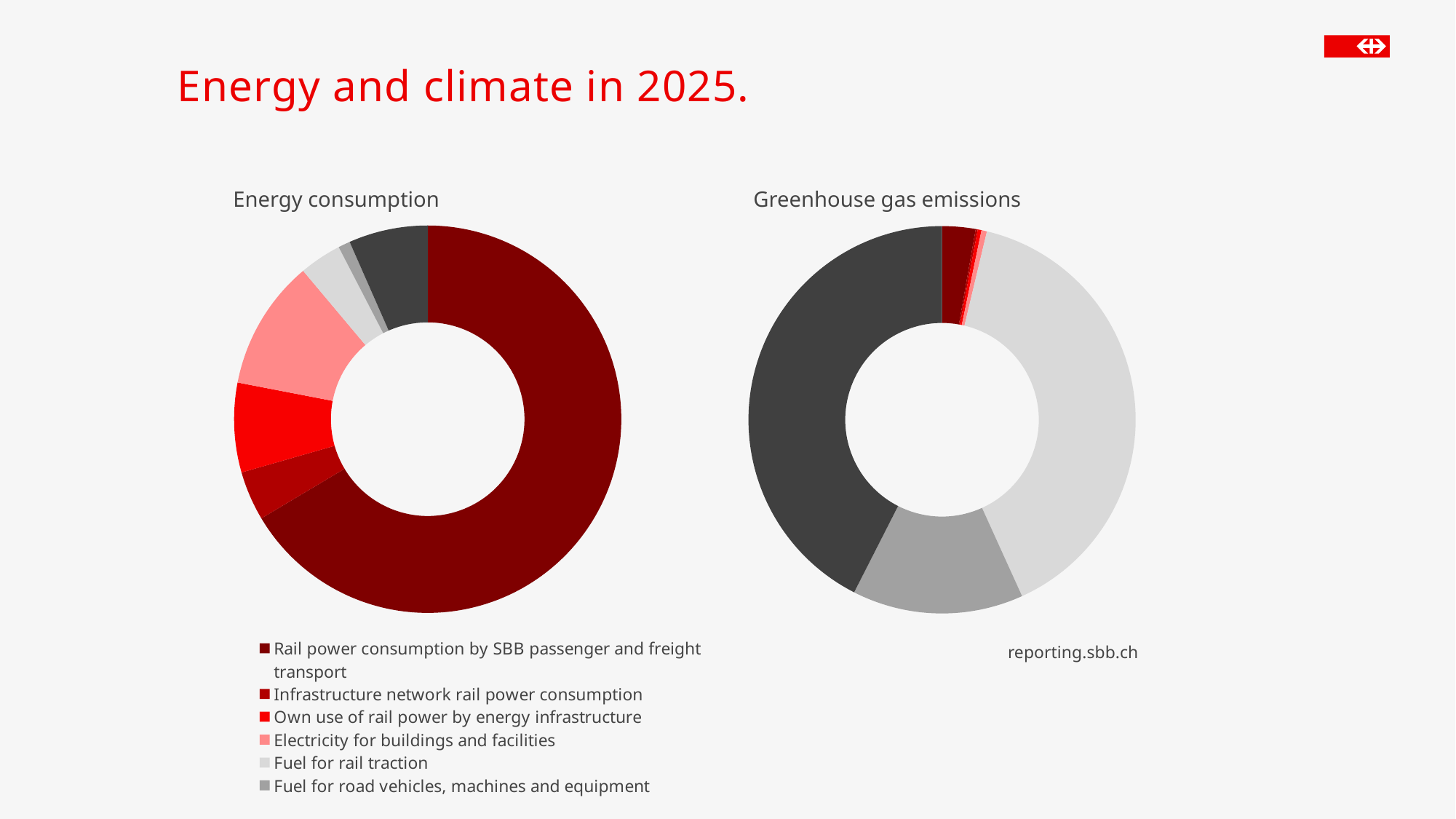
What kind of chart is the Greenhouse gas emissions chart? Donut (pie) chart How many slices does the Energy consumption donut have? 7 What is the title of the slide? Energy and climate in 2025. In the Energy consumption chart, which is larger: Own use of rail power by energy infrastructure or Fuel for road vehicles, machines and equipment? Own use of rail power by energy infrastructure In the Energy consumption chart, which category has the largest share? Rail power consumption by SBB passenger and freight transport What is the title of the chart on the right? Greenhouse gas emissions In the Energy consumption chart, is the share of Rail power consumption by SBB passenger and freight transport greater or less than half of the donut? greater How many entries does the legend list? 6 What kind of chart is the Energy consumption chart? Donut (pie) chart In the Energy consumption chart, which is larger: Rail power consumption by SBB passenger and freight transport or Electricity for buildings and facilities? Rail power consumption by SBB passenger and freight transport